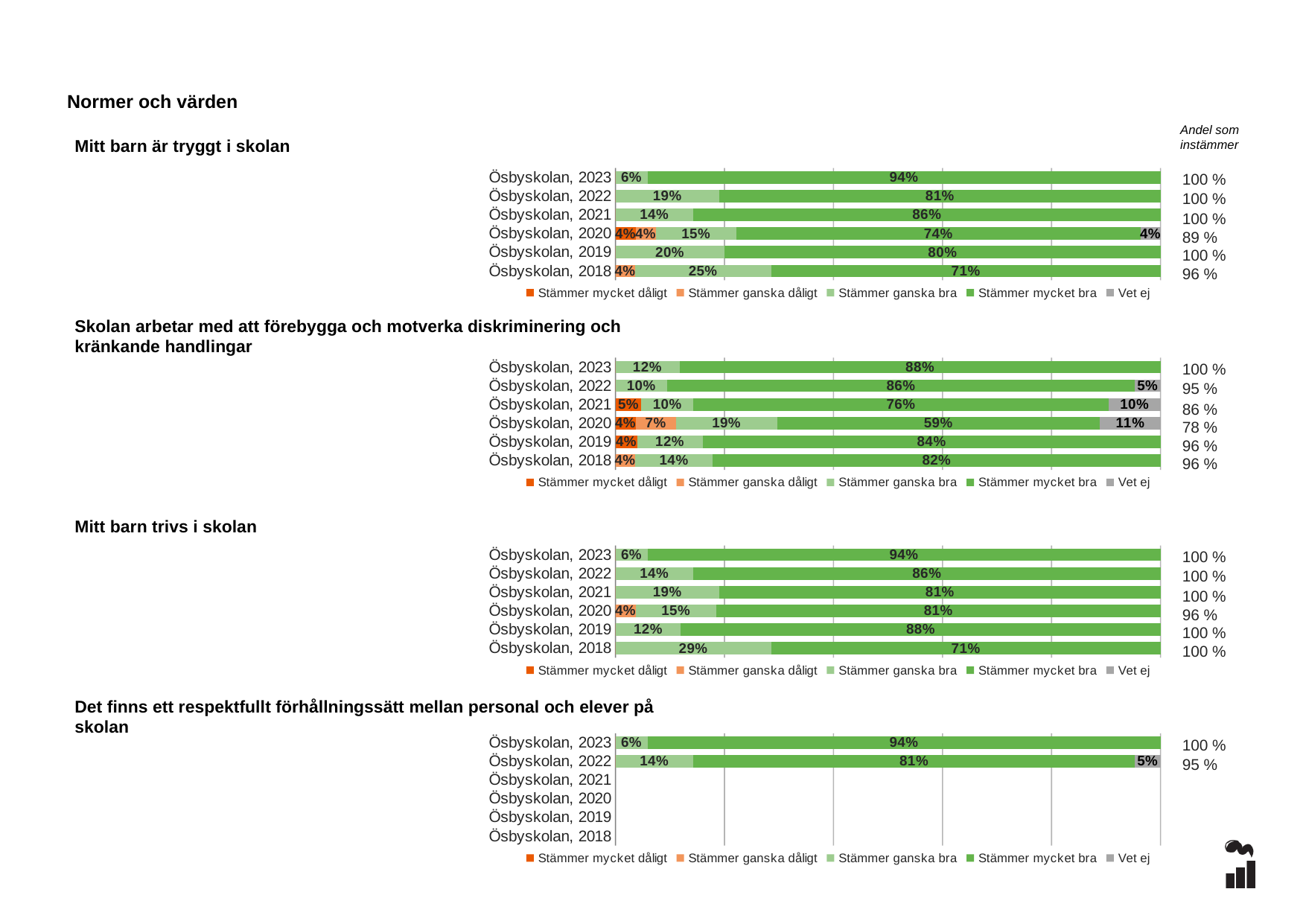
How many categories (years) are listed on the axis of the chart 'Det finns ett respektfullt förhållningssätt mellan personal och elever på skolan'? 6 In the chart 'Skolan arbetar med att förebygga och motverka diskriminering och kränkande handlingar', which year has the highest value for 'Stämmer mycket bra'? Ösbyskolan, 2023 In the chart 'Skolan arbetar med att förebygga och motverka diskriminering och kränkande handlingar', what is the difference between the 'Stämmer mycket bra' values for Ösbyskolan, 2023 and Ösbyskolan, 2020? 29% In the chart 'Mitt barn är tryggt i skolan', what is the value for 'Stämmer ganska bra' for Ösbyskolan, 2018? 25% In the chart 'Mitt barn är tryggt i skolan', which year has the lowest value for 'Stämmer mycket bra'? Ösbyskolan, 2018 In the chart 'Mitt barn trivs i skolan', what is the value for 'Stämmer ganska bra' for Ösbyskolan, 2018? 29% What kind of chart is 'Mitt barn är tryggt i skolan'? Stacked bar chart In the chart 'Mitt barn är tryggt i skolan', what is the value for 'Stämmer mycket bra' for Ösbyskolan, 2023? 94% In the chart 'Det finns ett respektfullt förhållningssätt mellan personal och elever på skolan', what is the value for 'Vet ej' for Ösbyskolan, 2022? 5% In the chart 'Mitt barn trivs i skolan', which is larger: 'Stämmer mycket bra' for Ösbyskolan, 2019 or for Ösbyskolan, 2021? Ösbyskolan, 2019 How many series does the legend list in the chart 'Mitt barn trivs i skolan'? 5 In the chart 'Skolan arbetar med att förebygga och motverka diskriminering och kränkande handlingar', what is the value for 'Vet ej' for Ösbyskolan, 2020? 11%